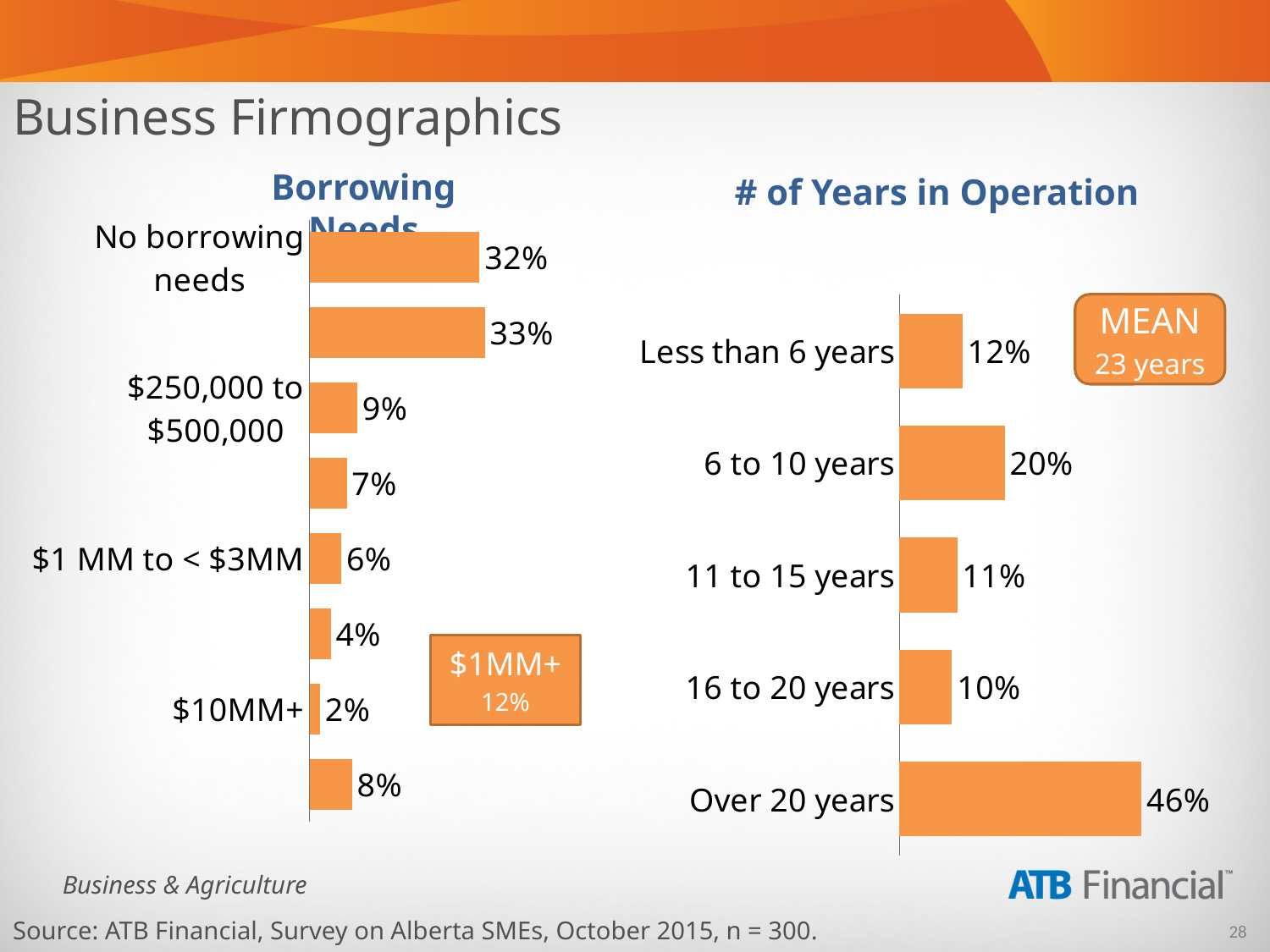
What type of chart is the '# of Years in Operation' chart? Bar chart In the '# of Years in Operation' chart, which category has the highest value? Over 20 years In the '# of Years in Operation' chart, which category has the lowest value? 16 to 20 years In the 'Borrowing Needs' chart, what is the value for '$250,000 to $500,000'? 9% In the '# of Years in Operation' chart, what is the difference between 'Over 20 years' and 'Less than 6 years'? 34% In the 'Borrowing Needs' chart, what percentage of businesses have no borrowing needs? 32% In the '# of Years in Operation' chart, how many categories are shown? 5 In the '# of Years in Operation' chart, what percentage of businesses have been operating for over 20 years? 46% In the '# of Years in Operation' chart, what is the value for '6 to 10 years'? 20% In the 'Borrowing Needs' chart, what is the value for '$10MM+'? 2% In the '# of Years in Operation' chart, what is the mean number of years in operation shown in the callout? 23 years In the 'Borrowing Needs' chart, which is larger: 'No borrowing needs' or '$1 MM to < $3MM'? No borrowing needs